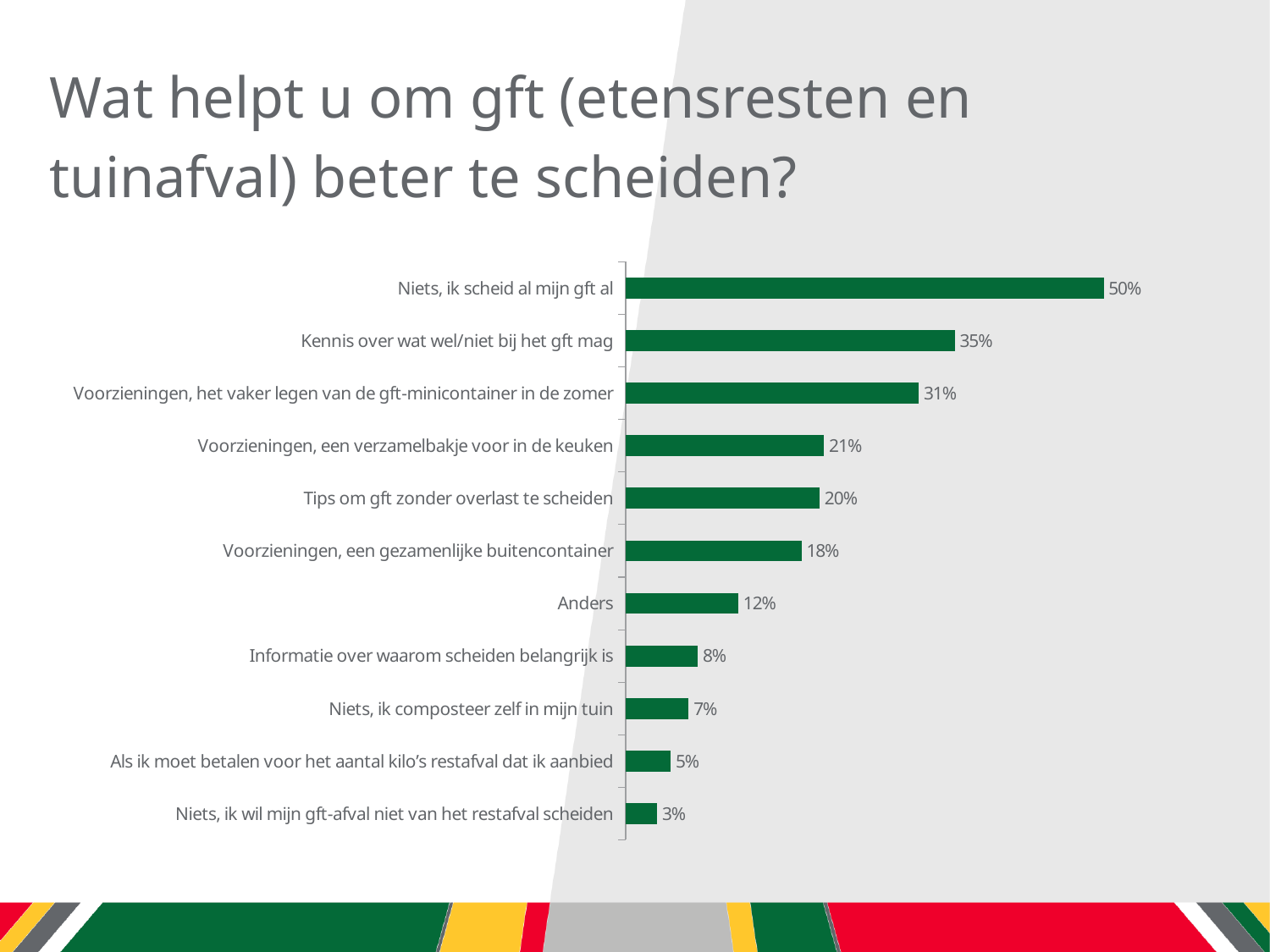
Which category has the lowest value? Niets, ik wil mijn gft-afval niet van het restafval scheiden Which category has the highest value? Niets, ik scheid al mijn gft al What is the difference between the values for "Kennis over wat wel/niet bij het gft mag" and "Voorzieningen, het vaker legen van de gft-minicontainer in de zomer"? 4% What colour are the bars in the chart? Green What is the value for "Kennis over wat wel/niet bij het gft mag"? 35% How many categories are shown in the chart? 11 What kind of chart is shown on the slide? Bar chart What is the value for "Niets, ik scheid al mijn gft al"? 50% Which is larger: the value for "Voorzieningen, een gezamenlijke buitencontainer" or the value for "Anders"? Voorzieningen, een gezamenlijke buitencontainer What is the value for "Niets, ik composteer zelf in mijn tuin"? 7% What is the difference between the values for "Informatie over waarom scheiden belangrijk is" and "Als ik moet betalen voor het aantal kilo’s restafval dat ik aanbied"? 3% What is the value for "Anders"? 12%